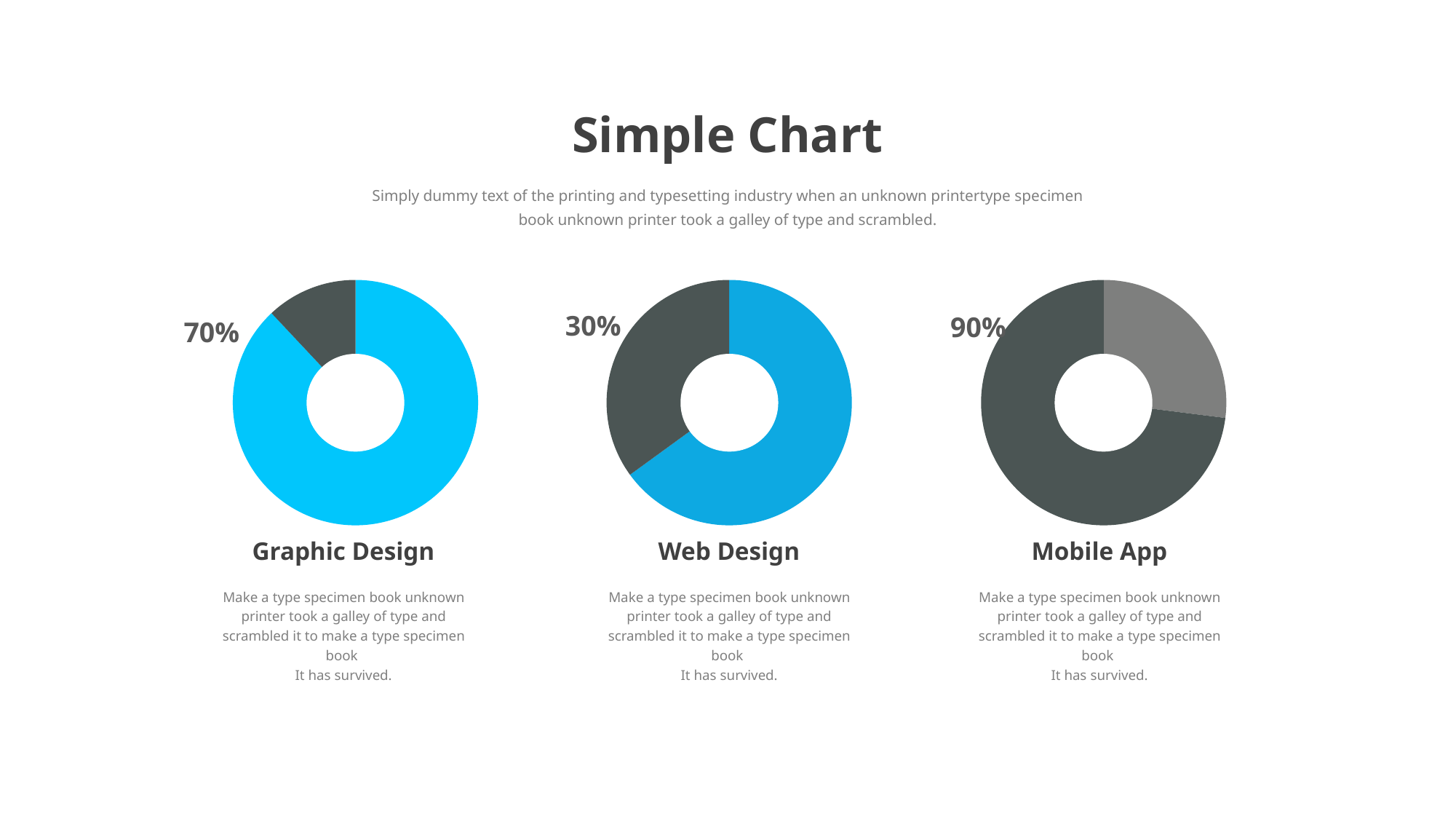
What percentage is shown for the Mobile App chart? 90% What is the difference between the percentage shown for Mobile App and the percentage shown for Graphic Design? 20% How many charts are shown on the slide? 3 What is the difference between the percentage shown for Graphic Design and the percentage shown for Web Design? 40% What percentage is shown for the Graphic Design chart? 70% Which of the three charts shows the lowest percentage? Web Design What colour is the large slice of the Graphic Design chart? Light blue What percentage is shown for the Web Design chart? 30% What kind of chart is used for Graphic Design, Web Design and Mobile App? Donut chart Which shows a larger percentage, the Graphic Design chart or the Web Design chart? Graphic Design What is the title of the slide? Simple Chart Which of the three charts shows the highest percentage? Mobile App